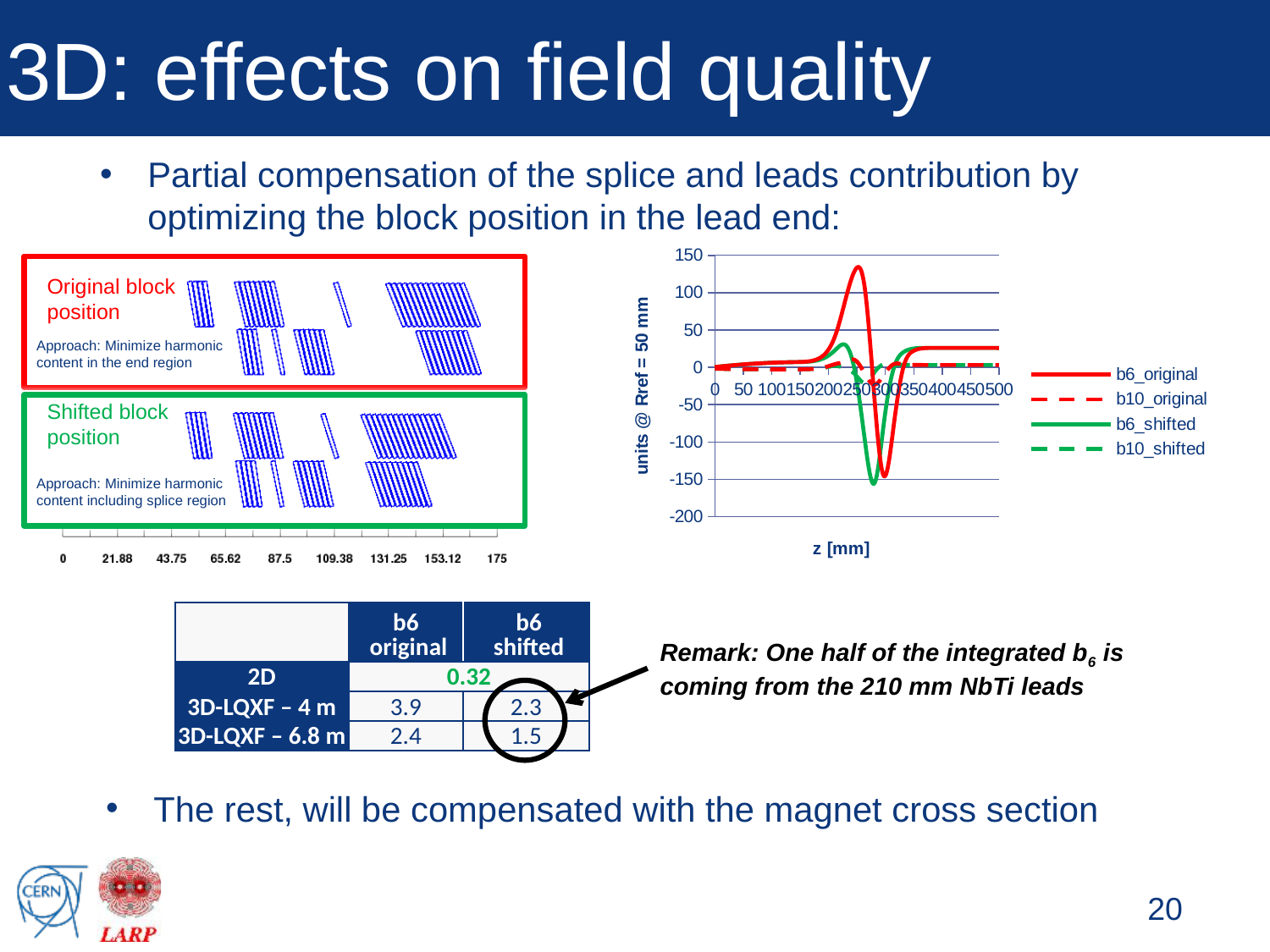
In the line chart, which series has the higher positive peak, b6_original or b6_shifted? b6_original What kind of chart is shown on the right of the slide? line chart In the line chart, is the maximum value reached by b6_shifted greater or less than 50? less What is the highest value shown on the x axis of the line chart? 500 How many series does the legend of the line chart list? 4 In the line chart, is the maximum value reached by b6_original greater or less than 100? greater What is the x-axis title of the line chart? z [mm] What is the lowest value shown on the y axis of the line chart? -200 In the line chart, is the value of b6_original at z = 450 mm greater or less than 50? less In the line chart, which series reaches the highest positive peak? b6_original